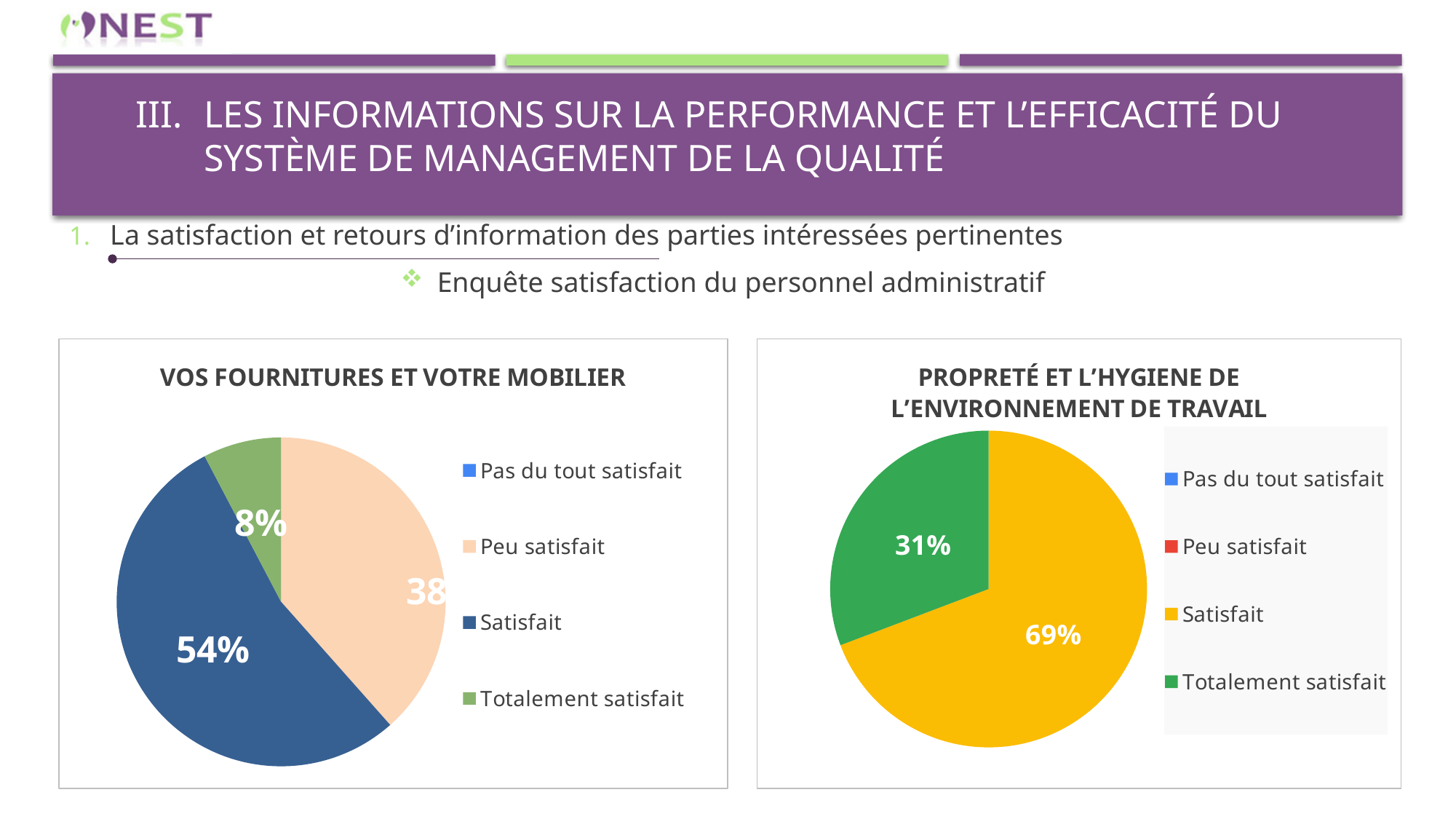
In the chart titled "VOS FOURNITURES ET VOTRE MOBILIER", how many entries does the legend list? 4 In the chart titled "PROPRETÉ ET L'HYGIENE DE L'ENVIRONNEMENT DE TRAVAIL", what is the difference in percentage points between "Satisfait" and "Totalement satisfait"? 38 In the chart titled "PROPRETÉ ET L'HYGIENE DE L'ENVIRONNEMENT DE TRAVAIL", what colour is the "Satisfait" slice? Yellow In the chart titled "VOS FOURNITURES ET VOTRE MOBILIER", which of the labelled slices is the smallest? Totalement satisfait In the chart titled "PROPRETÉ ET L'HYGIENE DE L'ENVIRONNEMENT DE TRAVAIL", what percentage of respondents answered "Totalement satisfait"? 31% In the chart titled "VOS FOURNITURES ET VOTRE MOBILIER", which category has the largest share of the pie? Satisfait In the chart titled "PROPRETÉ ET L'HYGIENE DE L'ENVIRONNEMENT DE TRAVAIL", what percentage of respondents answered "Satisfait"? 69% In the chart titled "PROPRETÉ ET L'HYGIENE DE L'ENVIRONNEMENT DE TRAVAIL", which category has the largest share of the pie? Satisfait In the chart titled "VOS FOURNITURES ET VOTRE MOBILIER", which slice is larger: "Satisfait" or "Peu satisfait"? Satisfait In the chart titled "VOS FOURNITURES ET VOTRE MOBILIER", what percentage of respondents answered "Satisfait"? 54% In the chart titled "VOS FOURNITURES ET VOTRE MOBILIER", what percentage of respondents answered "Totalement satisfait"? 8% What type of chart is used for "PROPRETÉ ET L'HYGIENE DE L'ENVIRONNEMENT DE TRAVAIL"? Pie chart